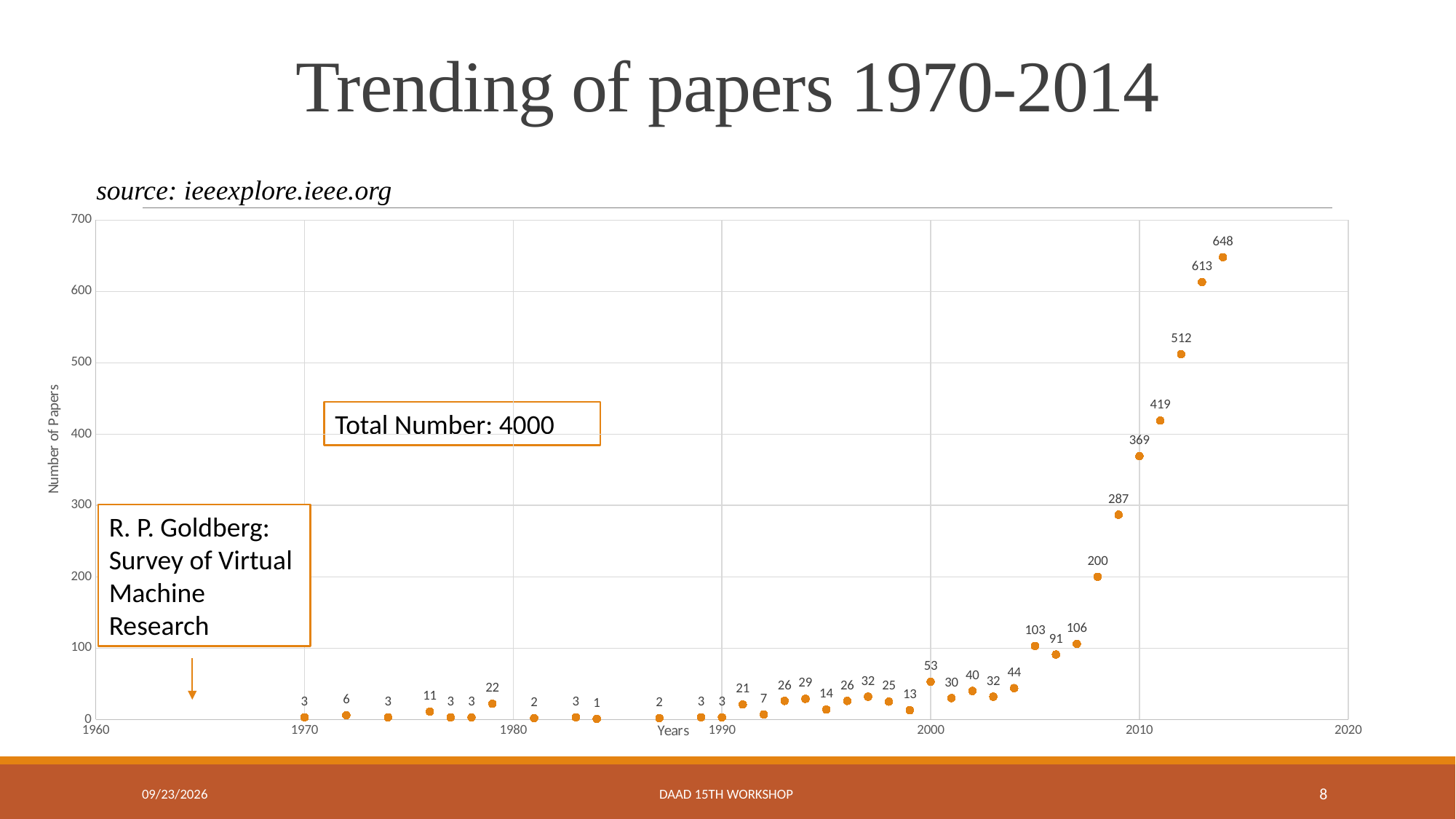
What is the number of papers for 2008? 200 Overall, do the number of papers rise or fall from 2005 to 2014? rise What is the number of papers for 2014? 648 What type of chart is shown on the slide? scatter chart What is the difference in number of papers between 2012 and 2011? 93 What total number of papers is stated in the box on the chart? 4000 What is the highest number of papers shown on the chart? 648 What is the difference in number of papers between 2014 and 2013? 35 What is the number of papers for 2010? 369 Which year has more papers, 2005 or 2006? 2005 Which year has the highest number of papers? 2014 What is the number of papers for 2000? 53